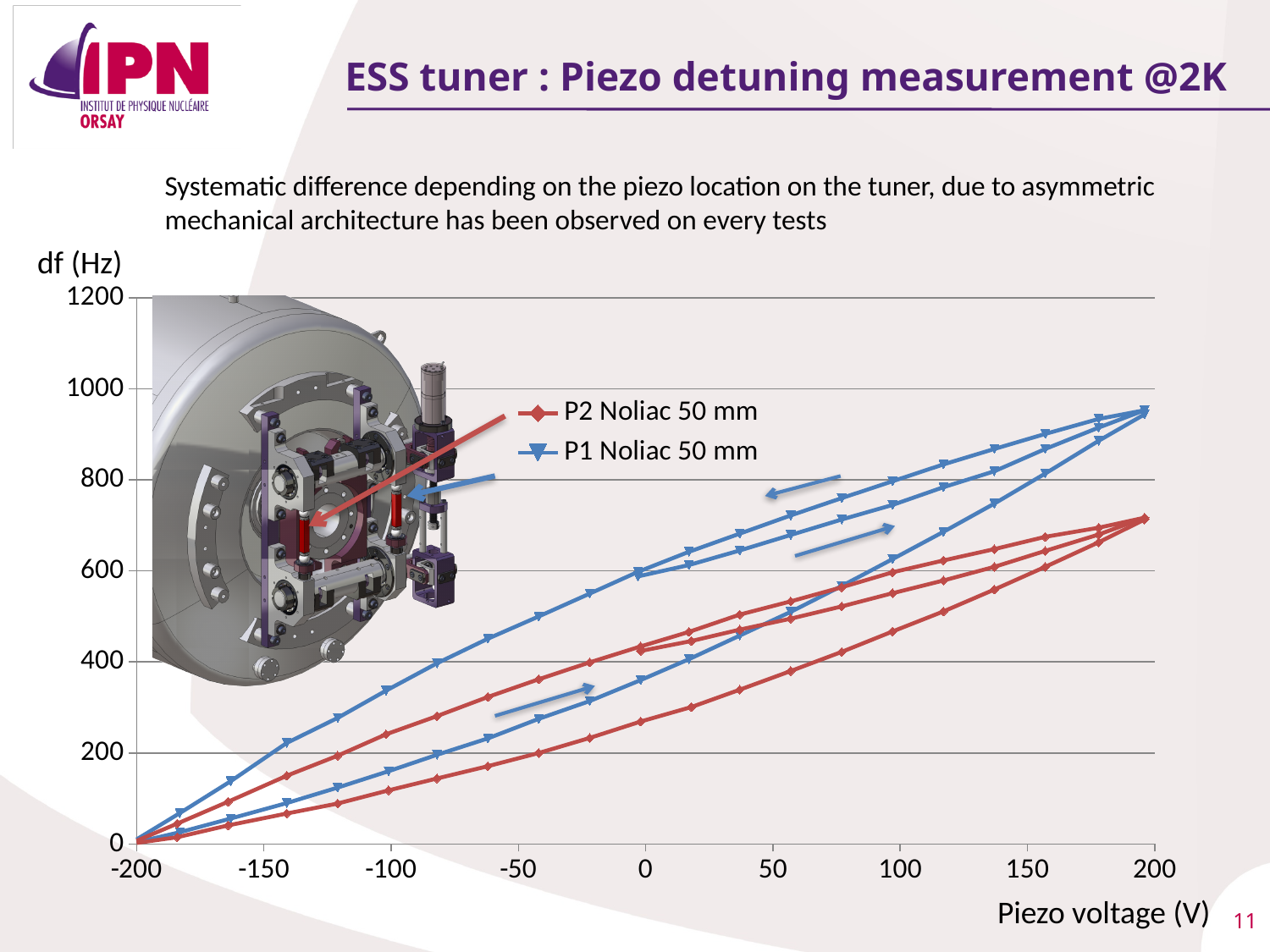
Which series reaches the highest df value on the chart? P1 Noliac 50 mm How many series does the legend list? 2 What is the value of df (Hz) for both series at a piezo voltage of -200 V? 0 At a piezo voltage of 200 V, which series has the higher df value, P1 Noliac 50 mm or P2 Noliac 50 mm? P1 Noliac 50 mm What are the two series named in the legend? P2 Noliac 50 mm and P1 Noliac 50 mm Is the value of P2 Noliac 50 mm at 200 V greater or less than 800 Hz? less What is the label of the x axis? Piezo voltage (V) Do the df values rise or fall as the piezo voltage increases from -200 V to 200 V? rise What is the highest tick value shown on the df (Hz) axis? 1200 What kind of chart is shown on the slide? line chart Is the value of P1 Noliac 50 mm at 200 V greater or less than 800 Hz? greater Is the value of P2 Noliac 50 mm at 200 V greater or less than 600 Hz? greater